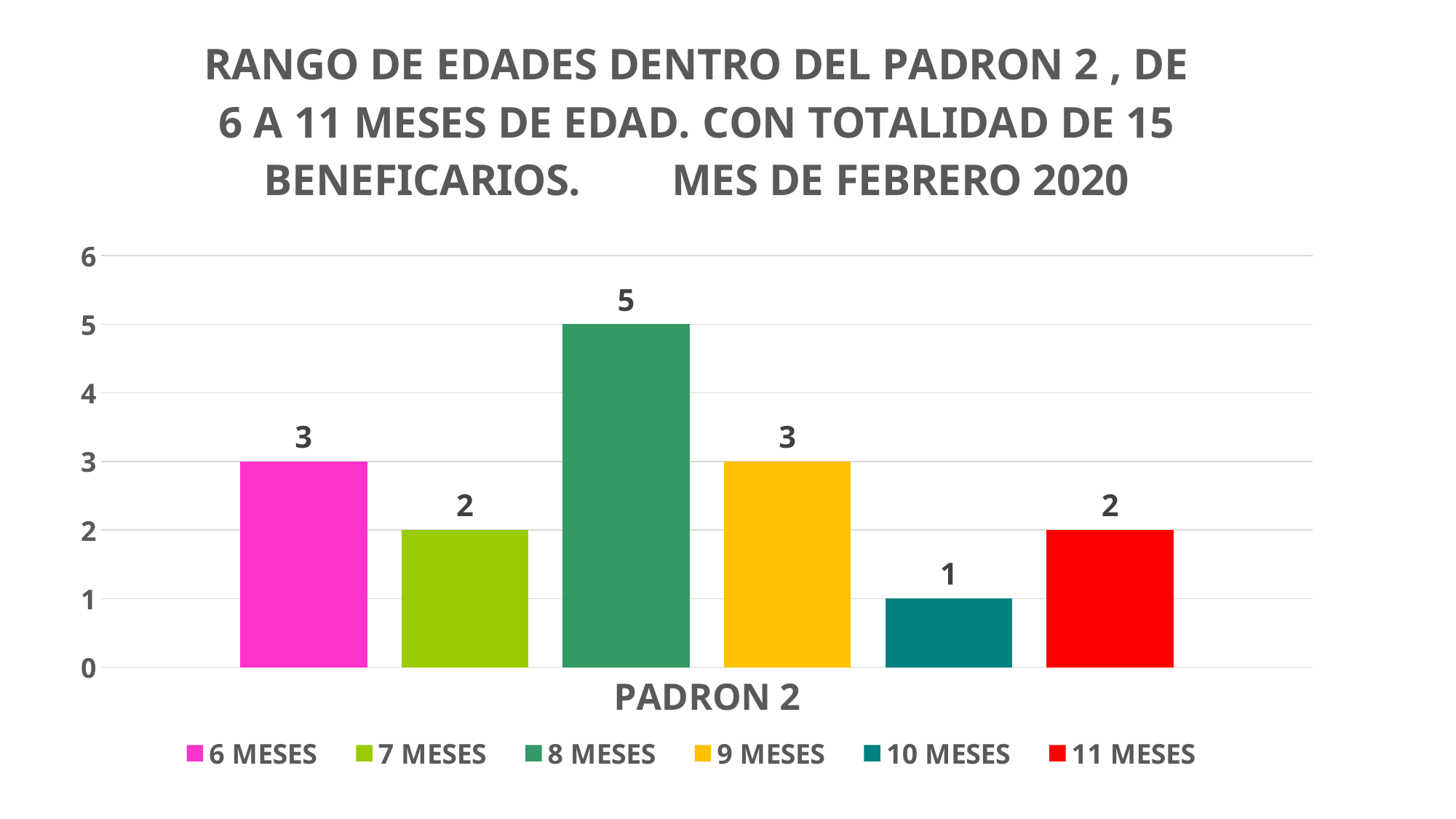
What is the value for 6 MESES? 3 What is the value for 8 MESES? 5 Which series has the highest value? 8 MESES What colour is the bar for 9 MESES? yellow What is the value for 10 MESES? 1 What is the difference between the values for 8 MESES and 7 MESES? 3 What kind of chart is shown on the slide? bar chart What is the category label shown on the x axis? PADRON 2 How many series does the legend list? 6 Which series has the lowest value? 10 MESES What is the value for 11 MESES? 2 Which is larger, the value for 9 MESES or the value for 11 MESES? 9 MESES